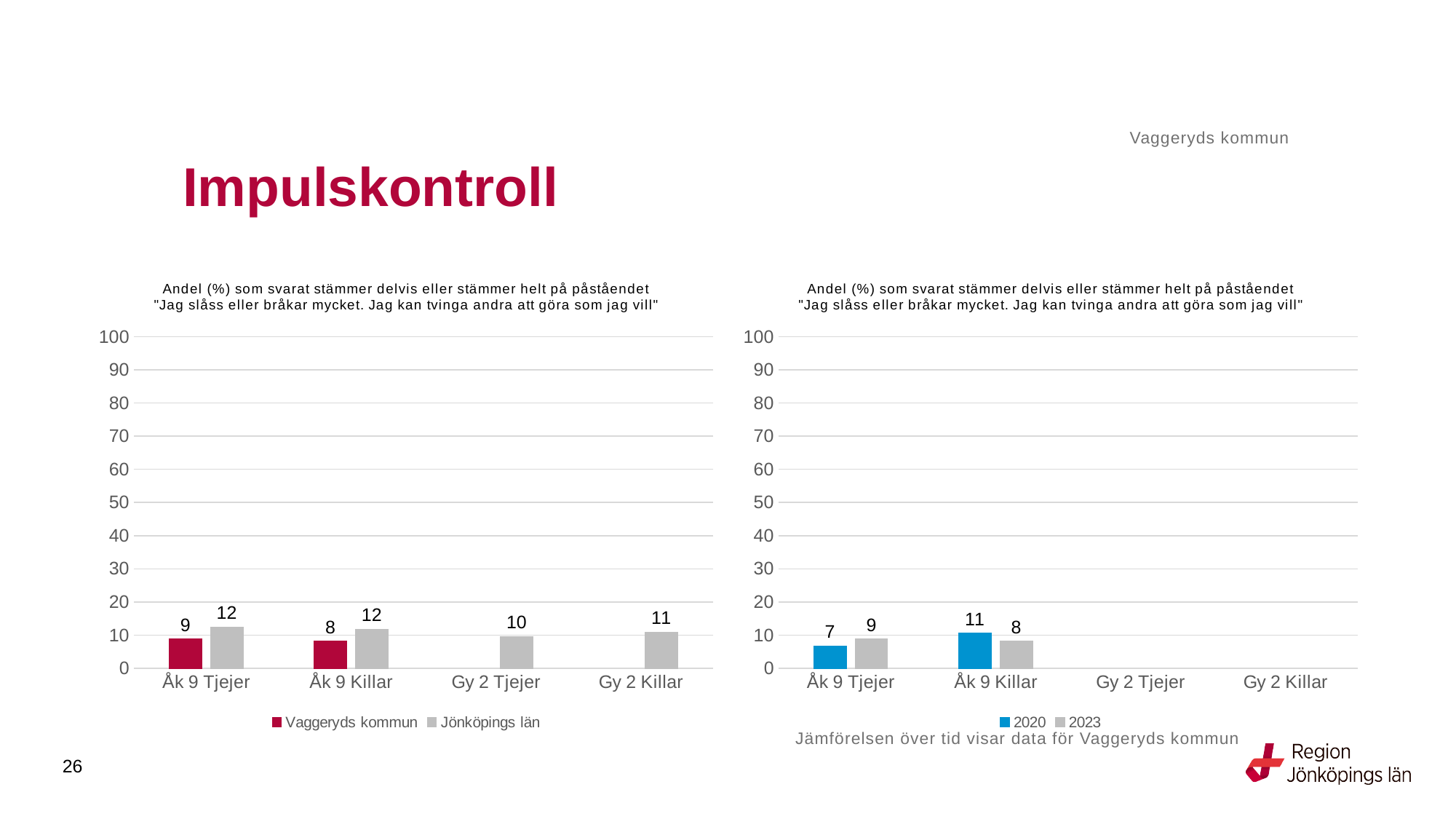
How many categories are shown on the x axis of the left chart? 4 In the right chart, what is the difference between 2020 and 2023 for Åk 9 Tjejer? 2 In the left chart, how many series does the legend list? 2 In the left chart, what is the value for Jönköpings län for Gy 2 Killar? 11 In the left chart, is the value for Jönköpings län for Åk 9 Tjejer greater or less than 10? greater In the right chart, what is the value for 2023 for Åk 9 Tjejer? 9 In the left chart, which category has the lowest value for Jönköpings län? Gy 2 Tjejer In the left chart, what is the difference between Jönköpings län and Vaggeryds kommun for Åk 9 Killar? 4 What kind of chart is the right chart? Bar chart In the right chart, what is the value for 2020 for Åk 9 Killar? 11 In the left chart, what is the value for Vaggeryds kommun for Åk 9 Tjejer? 9 In the right chart, which is larger for Åk 9 Killar, 2020 or 2023? 2020